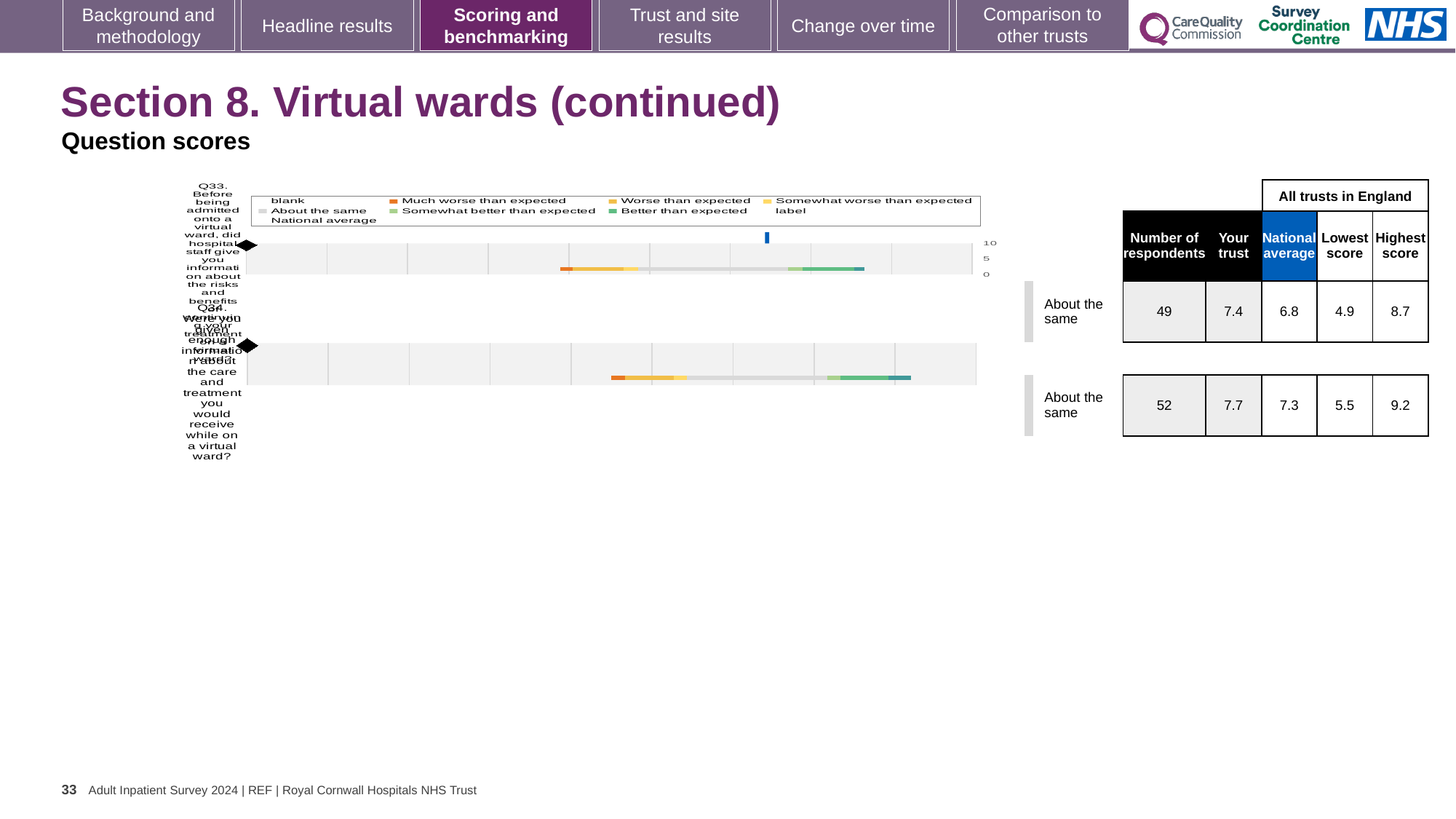
In the table next to the chart, what is the highest score for Q34? 9.2 What benchmark category is shown for Q33 next to the chart? About the same What kind of chart is shown on the slide? bar chart Which question has the higher 'Your trust' score, Q33 or Q34? Q34 In the table next to the chart, what is the 'Your trust' score for Q33? 7.4 In the table next to the chart, how many respondents answered Q34? 52 In the table next to the chart, what is the 'Your trust' score for Q34? 7.7 What is the difference between the 'Your trust' scores for Q34 and Q33? 0.3 What colour does the legend use for 'Much worse than expected'? orange In the table next to the chart, what is the national average for Q33? 6.8 How many questions (bars) are plotted in the chart? 2 Which two question numbers are plotted in the chart? Q33 and Q34